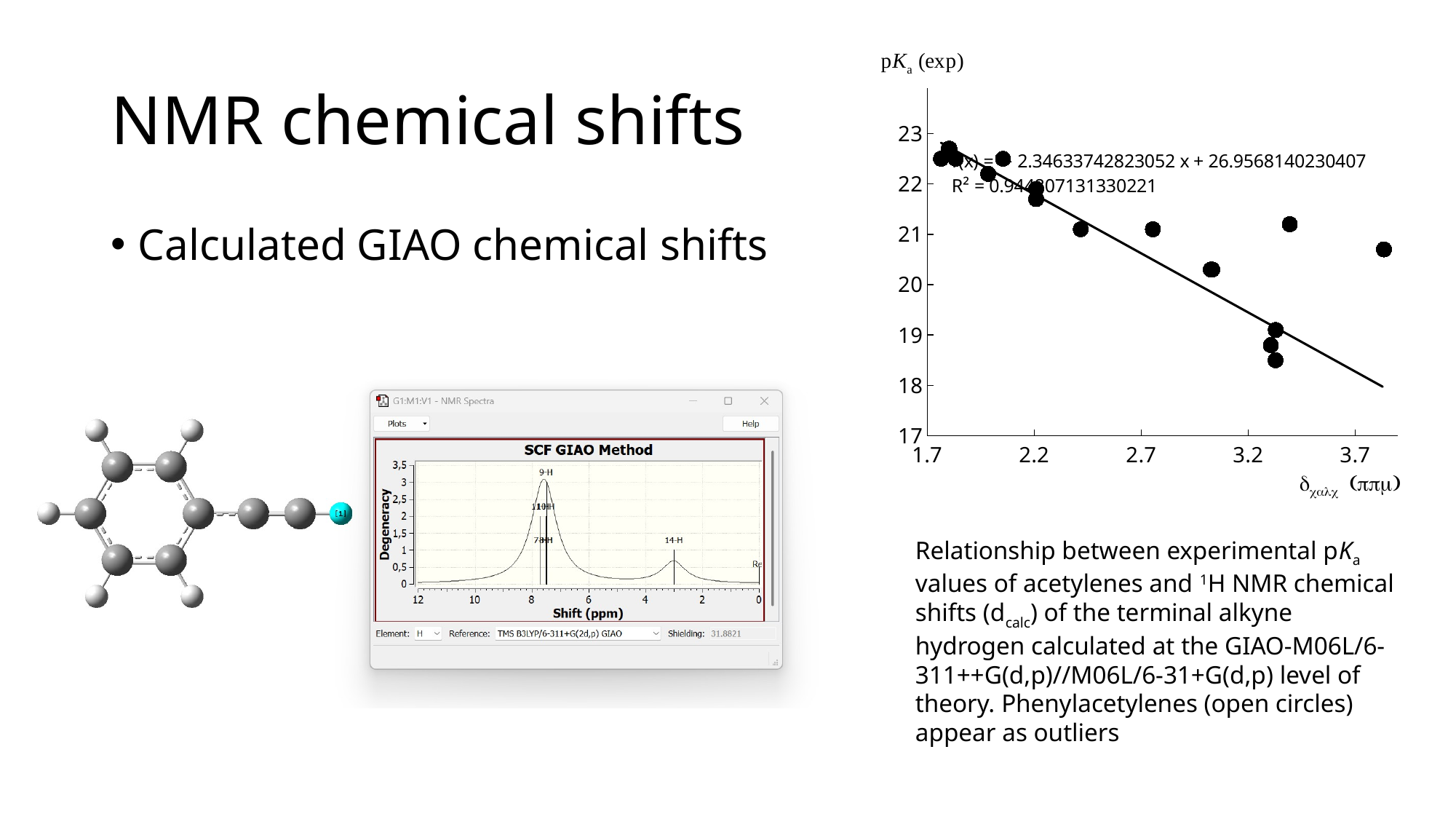
In the SCF GIAO Method spectrum chart, what is the label of the x axis? Shift (ppm) What is the title of the NMR spectrum chart in the screenshot at the bottom of the slide? SCF GIAO Method In the pKa (exp) scatter chart, what is the intercept shown in the trendline equation? 26.9568140230407 In the pKa (exp) scatter chart, what is the lowest tick value shown on the x axis? 1.7 In the pKa (exp) scatter chart, are the points near 1.8 on the x axis greater or less than 22? greater What kind of chart is the pKa (exp) chart on the right of the slide? scatter chart In the SCF GIAO Method spectrum chart, which labelled peak is the tallest? 9-H In the pKa (exp) scatter chart, is the value of the rightmost point (near 3.8 on the x axis) greater or less than 20? greater In the pKa (exp) scatter chart, do the pKa values rise or fall as the chemical shift on the x axis increases? fall In the SCF GIAO Method spectrum chart, is the height of the 14-H peak greater or less than 1? less